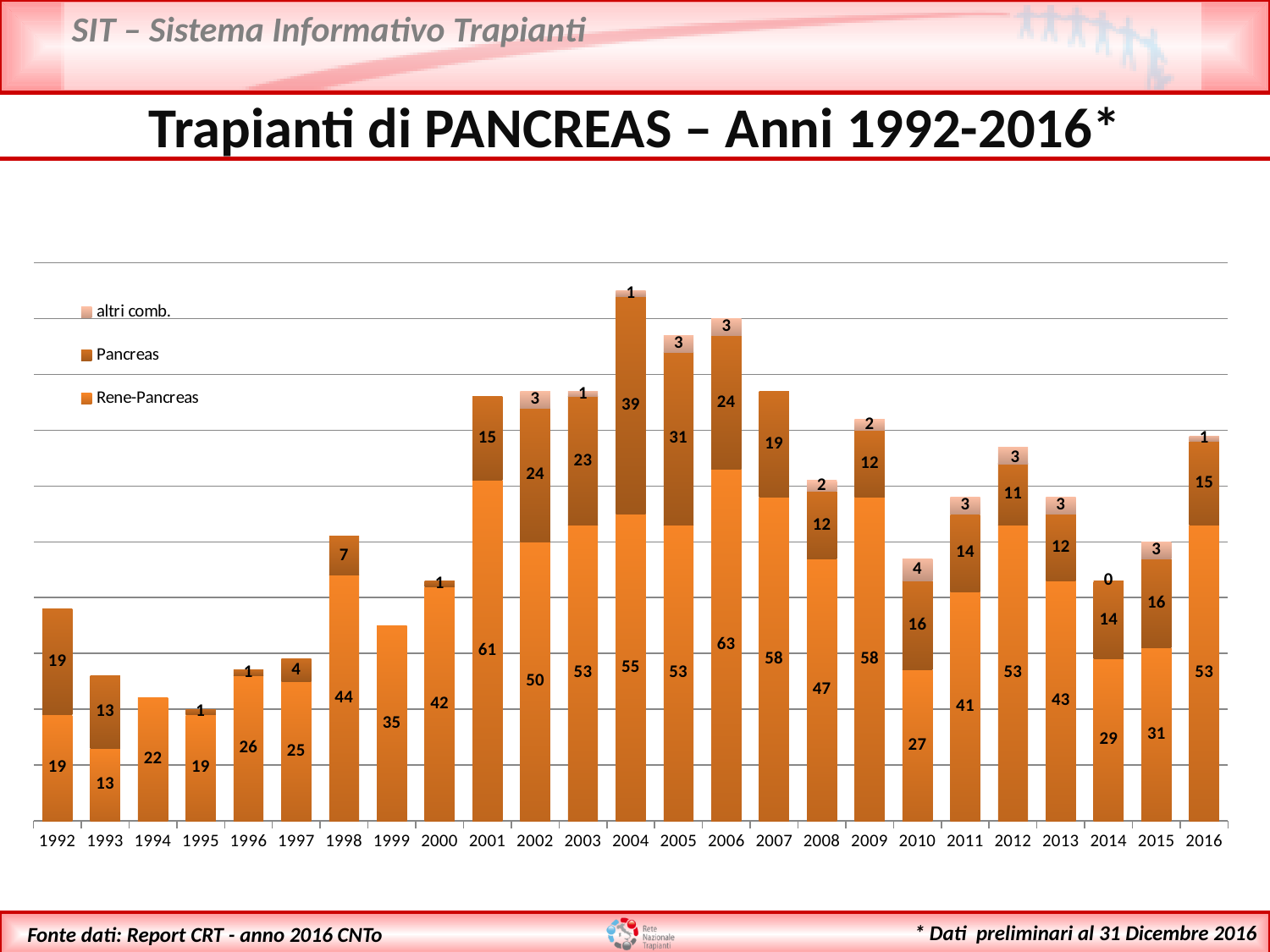
Which year has the larger Rene-Pancreas value, 2001 or 2002? 2001 What is the total of the stacked bar for 2004? 95 What is the Pancreas value for 2004? 39 What kind of chart is shown on the slide? Stacked bar chart Which year has the lowest Rene-Pancreas value? 1993 What is the Rene-Pancreas value for 2006? 63 How many series does the legend list? 3 What is the total of the stacked bar for 2016? 69 How many years are shown on the x axis? 25 What is the altri comb. value for 2010? 4 Which year has the highest Rene-Pancreas value? 2006 What is the difference between the Pancreas values for 2004 and 2005? 8